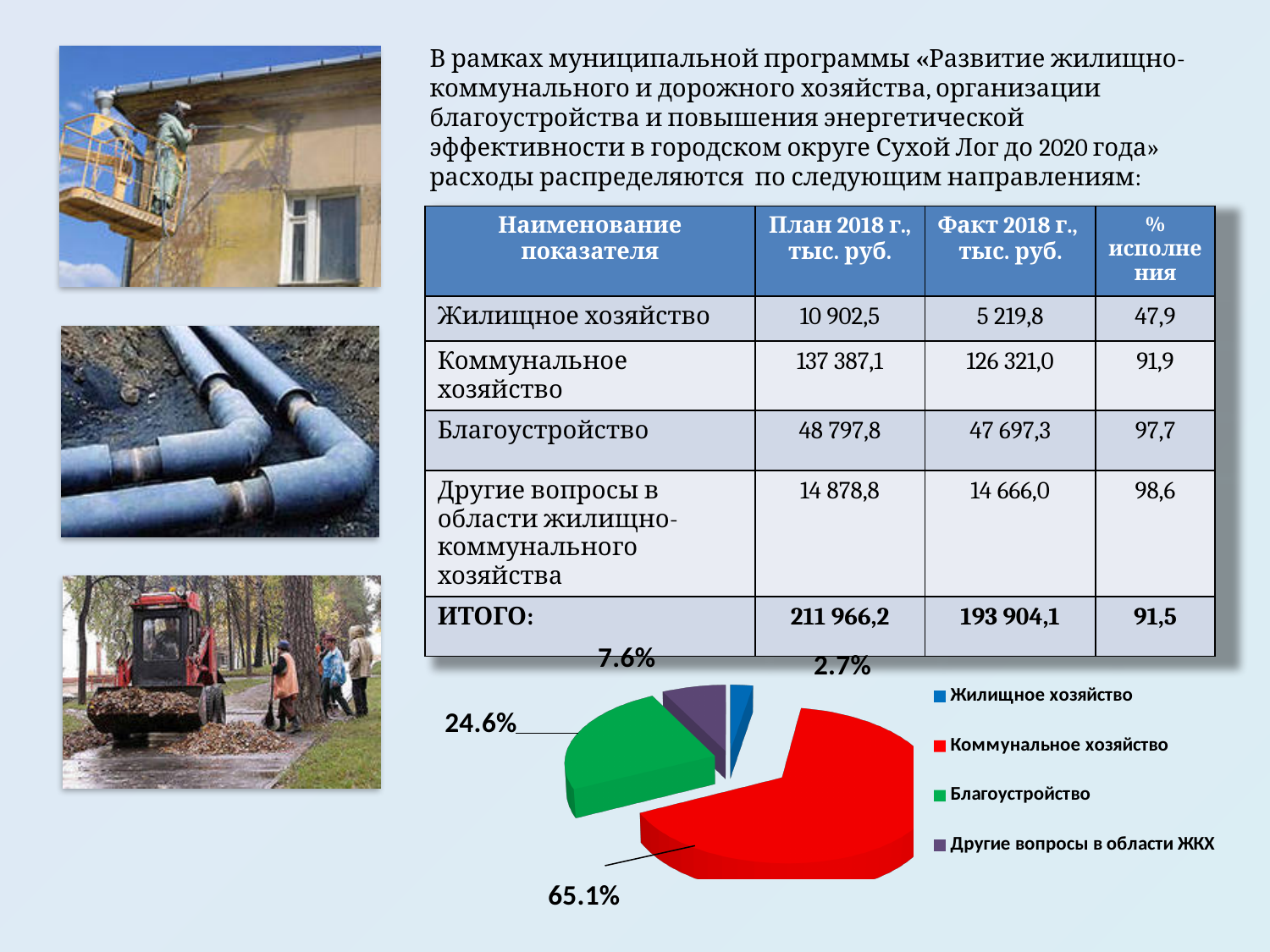
What kind of chart is shown at the bottom of the slide? pie chart In the pie chart, which is larger: Благоустройство or Другие вопросы в области ЖКХ? Благоустройство Which category has the smallest slice in the pie chart? Жилищное хозяйство What share of the pie chart does Благоустройство have? 24.6% What share of the pie chart does Коммунальное хозяйство have? 65.1% What is the difference in percentage points between the Коммунальное хозяйство and Благоустройство slices in the pie chart? 40.5 How many slices does the pie chart have? 4 What share of the pie chart does Другие вопросы в области ЖКХ have? 7.6% What colour is the Благоустройство slice in the pie chart? green How many entries does the pie chart legend list? 4 Which category has the largest slice in the pie chart? Коммунальное хозяйство